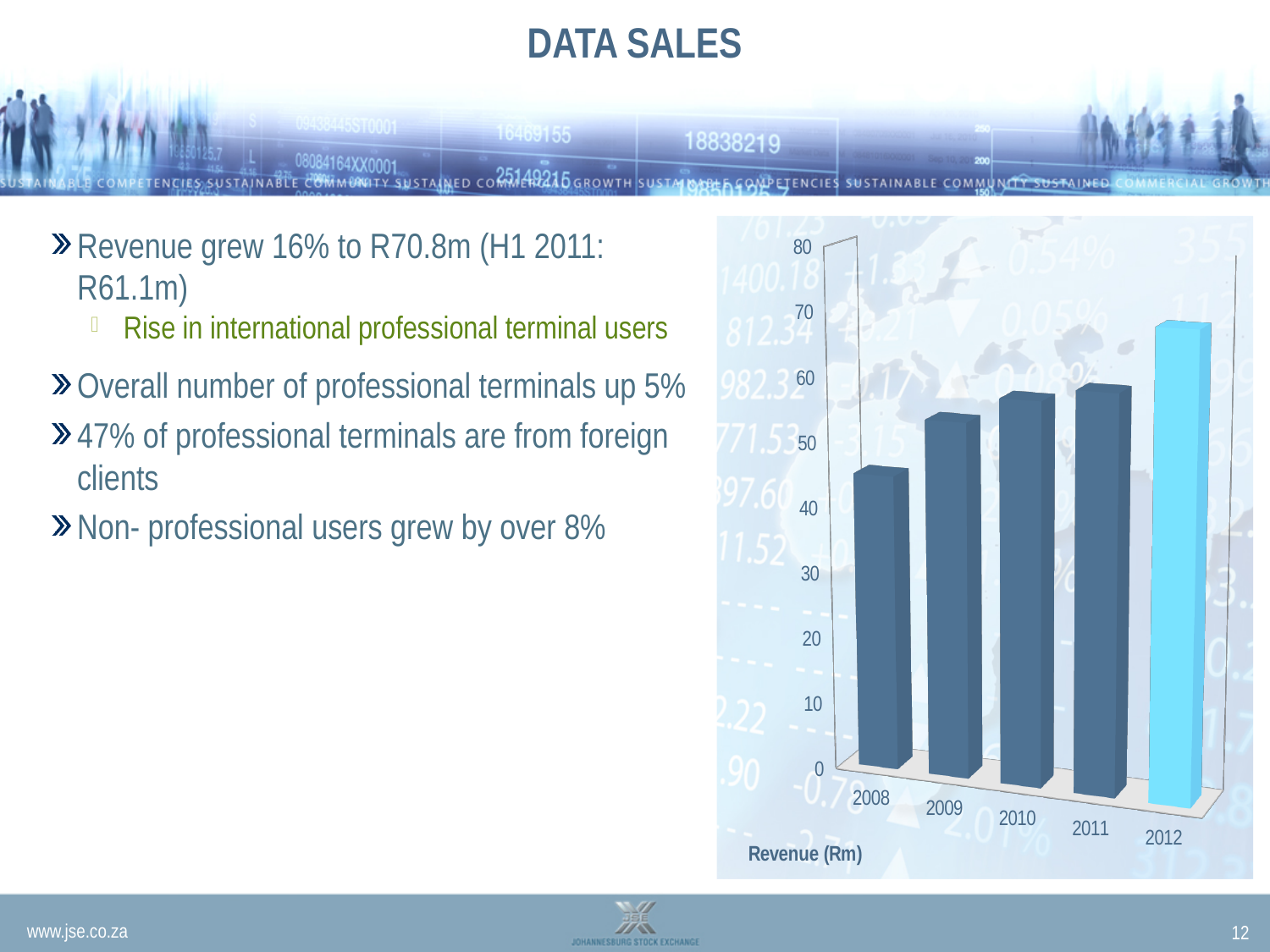
Is the value for 2010 greater or less than 50? greater Is the value for 2008 greater or less than 40? greater How many years are shown on the x axis of the chart? 5 Which year's bar is shown in a lighter blue colour than the others? 2012 What kind of chart is shown on the slide? bar chart Is the value for 2012 greater or less than 60? greater Which year has the highest bar in the chart? 2012 Which year has the lowest bar in the chart? 2008 Which is larger, the value for 2009 or the value for 2012? 2012 Do the values generally rise or fall from 2008 to 2012? rise